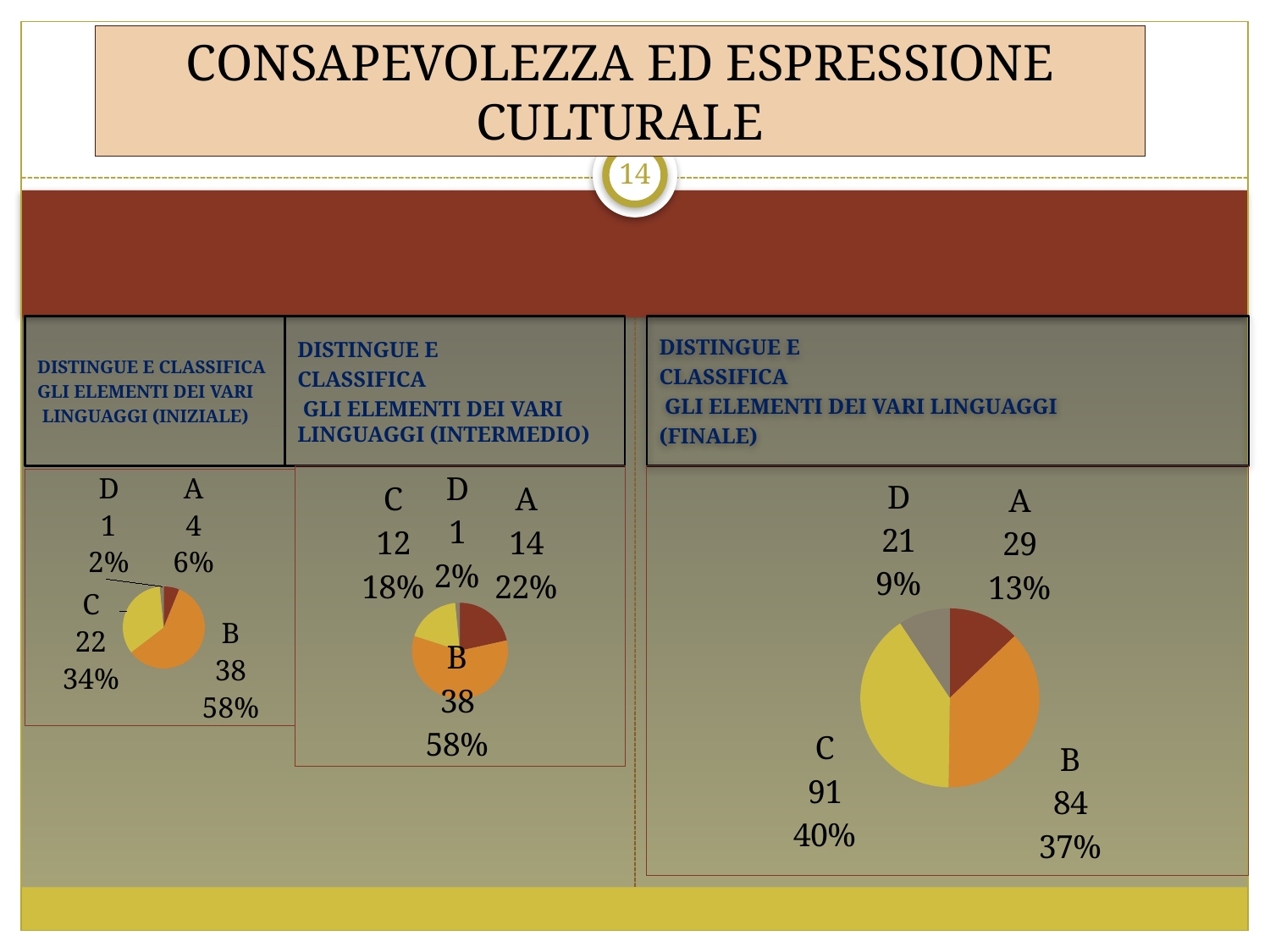
In the INTERMEDIO pie chart in the middle, what is the value for category A? 14 In the FINALE pie chart on the right, what is the difference between the values for C and B? 7 In the FINALE pie chart on the right, which category has the lowest value? D In the FINALE pie chart on the right, what share of the pie does category D represent? 9% In the INIZIALE pie chart on the left, what is the value for category B? 38 In the FINALE pie chart on the right, which category has the highest value? C In the INTERMEDIO pie chart in the middle, what is the difference between the values for B and C? 26 What type of chart is used in the FINALE panel on the right? Pie chart In the INIZIALE pie chart on the left, which is larger, the value for A or the value for C? C In the INTERMEDIO pie chart in the middle, what share of the pie does category C represent? 18% How many categories does the INTERMEDIO pie chart in the middle show? 4 In the INIZIALE pie chart on the left, what share of the pie does category C represent? 34%